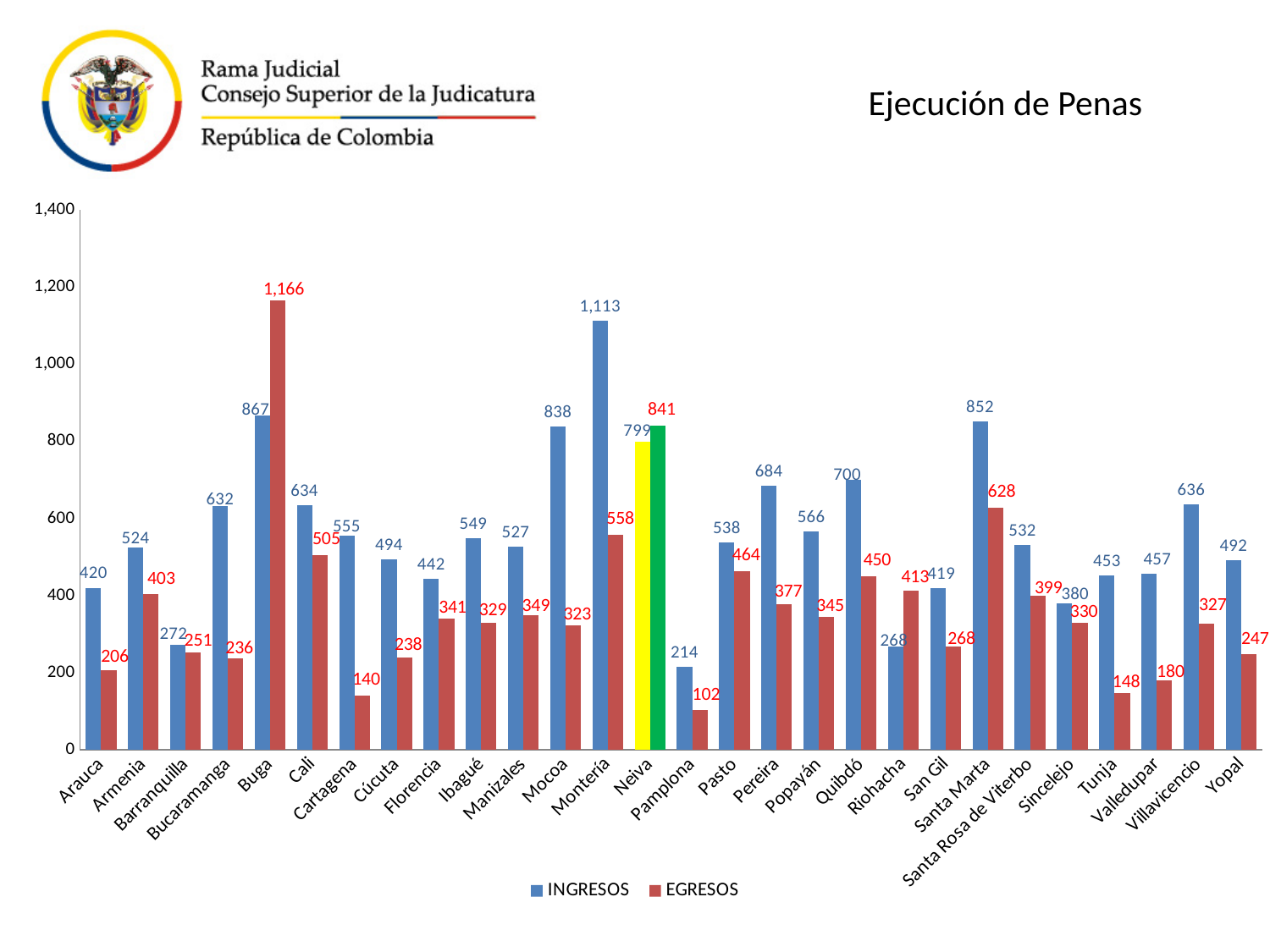
Which is larger for Riohacha, INGRESOS or EGRESOS? EGRESOS What is the EGRESOS value for Buga? 1,166 Which city has the lowest INGRESOS value? Pamplona Is the INGRESOS value for Santa Marta greater or less than 800? greater What kind of chart is shown on the slide? bar chart What is the INGRESOS value for Neiva? 799 Which city has the highest EGRESOS value? Buga What is the INGRESOS value for Montería? 1,113 What is the title shown on the slide above the chart? Ejecución de Penas How many series does the legend list? 2 What is the difference between INGRESOS and EGRESOS for Cartagena? 415 How many cities are shown on the x axis? 28